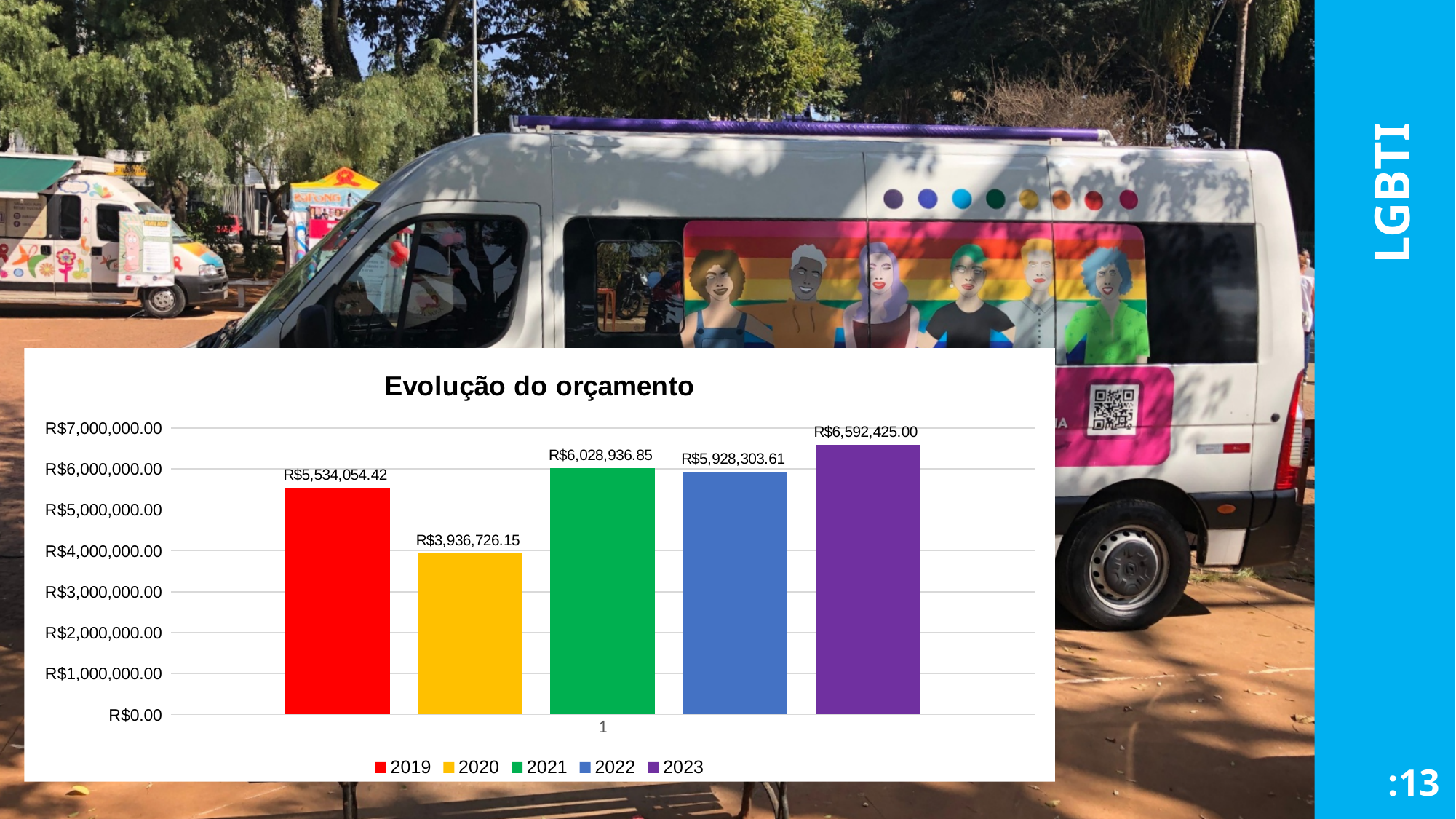
What is the difference between the values for 2023 and 2020? R$2,655,698.85 Is the value for 2020 greater or less than R$4,000,000.00? less Which year has the highest value? 2023 What is the value for 2023? R$6,592,425.00 What is the value for 2020? R$3,936,726.15 Which is larger, the value for 2021 or the value for 2022? 2021 What is the value for 2019? R$5,534,054.42 What is the value for 2021? R$6,028,936.85 Which year has the lowest value? 2020 What is the title of the chart? Evolução do orçamento What kind of chart is shown on the slide? bar chart How many series does the legend list? 5